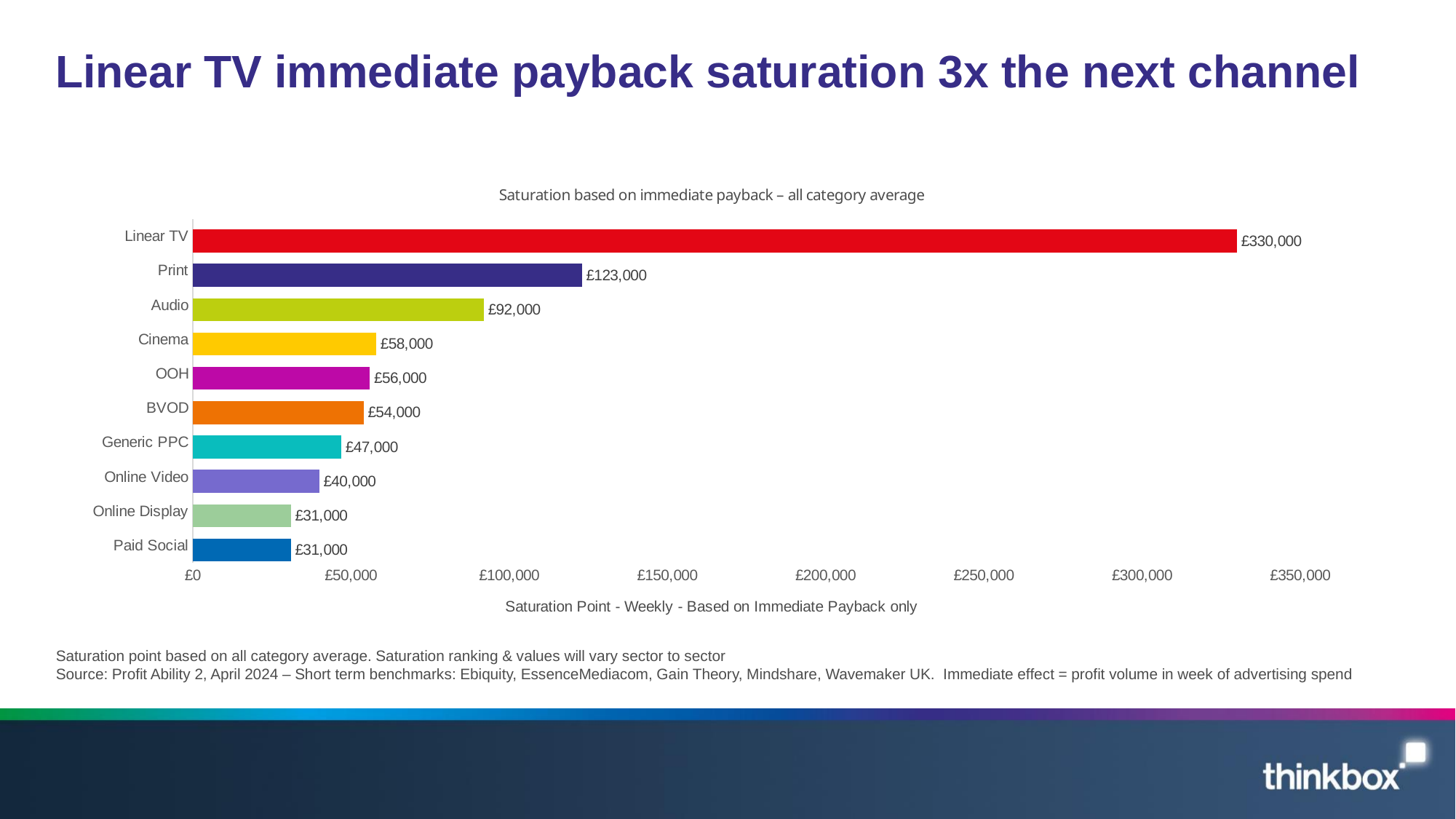
Is the saturation point for Online Video greater or less than £50,000? less Which channel has the lowest saturation point, other than Paid Social which shares the same value? Online Display What is the title of the chart? Saturation based on immediate payback – all category average Which channel has the highest saturation point? Linear TV What is the saturation point for Linear TV? £330,000 What is the difference between the saturation points of Cinema and BVOD? £4,000 What is the saturation point for Generic PPC? £47,000 Which has a higher saturation point, Print or Audio? Print What is the difference between the saturation points of Linear TV and Print? £207,000 What type of chart is shown on the slide? bar chart What is the saturation point for Audio? £92,000 How many channels are shown in the chart? 10